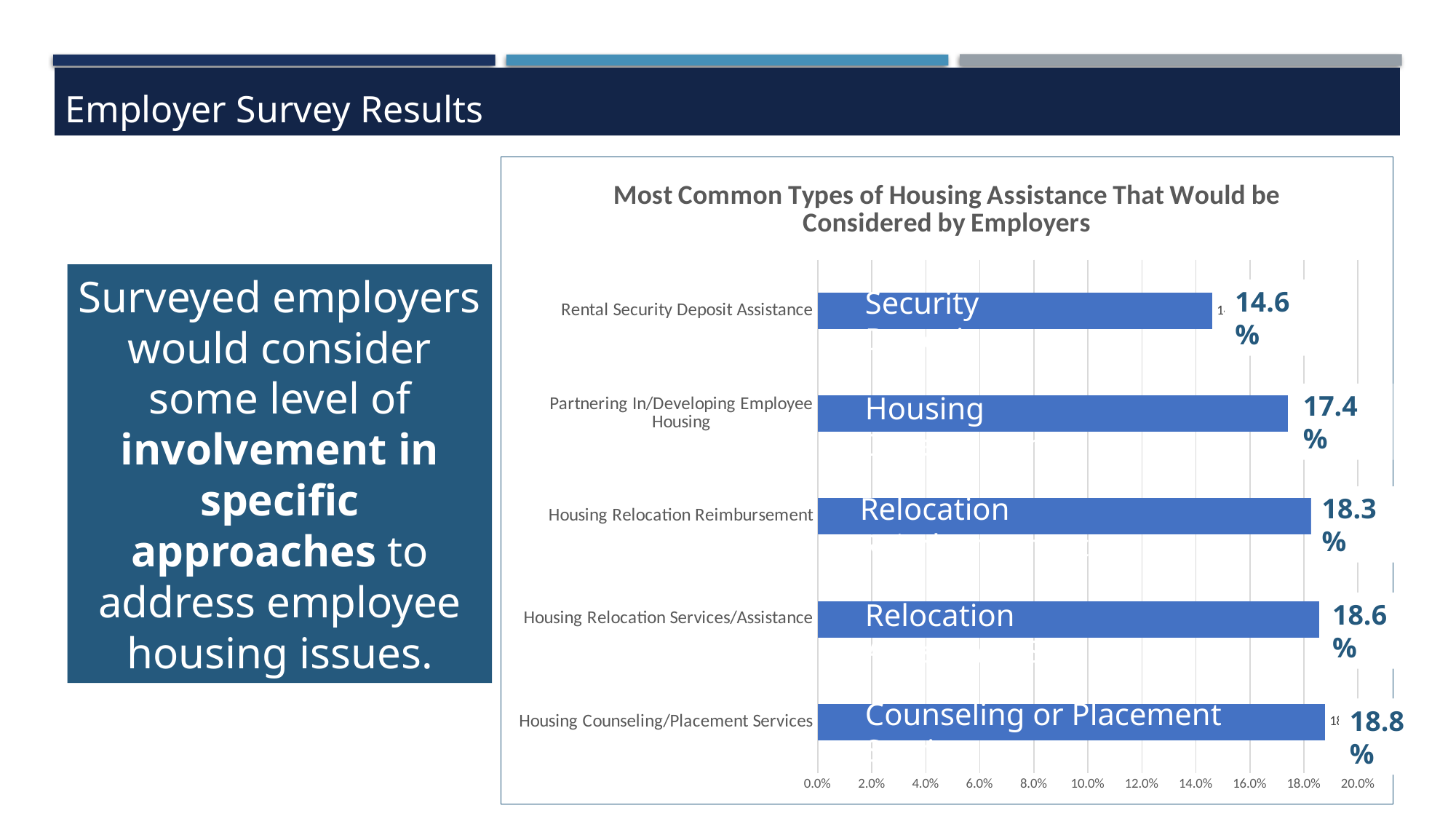
What is the value for Housing Counseling/Placement Services? 18.8% Which is larger: the value for Housing Relocation Services/Assistance or the value for Partnering In/Developing Employee Housing? Housing Relocation Services/Assistance Is the value for Rental Security Deposit Assistance greater or less than 16.0%? less What is the value for Partnering In/Developing Employee Housing? 17.4% What kind of chart is shown on the slide? Bar chart What is the value for Housing Relocation Reimbursement? 18.3% Which type of housing assistance has the lowest value? Rental Security Deposit Assistance What is the value for Rental Security Deposit Assistance? 14.6% What is the difference between the values for Housing Counseling/Placement Services and Rental Security Deposit Assistance? 4.2 percentage points Which type of housing assistance has the highest value? Housing Counseling/Placement Services What is the title of the chart? Most Common Types of Housing Assistance That Would be Considered by Employers How many types of housing assistance are shown in the chart? 5